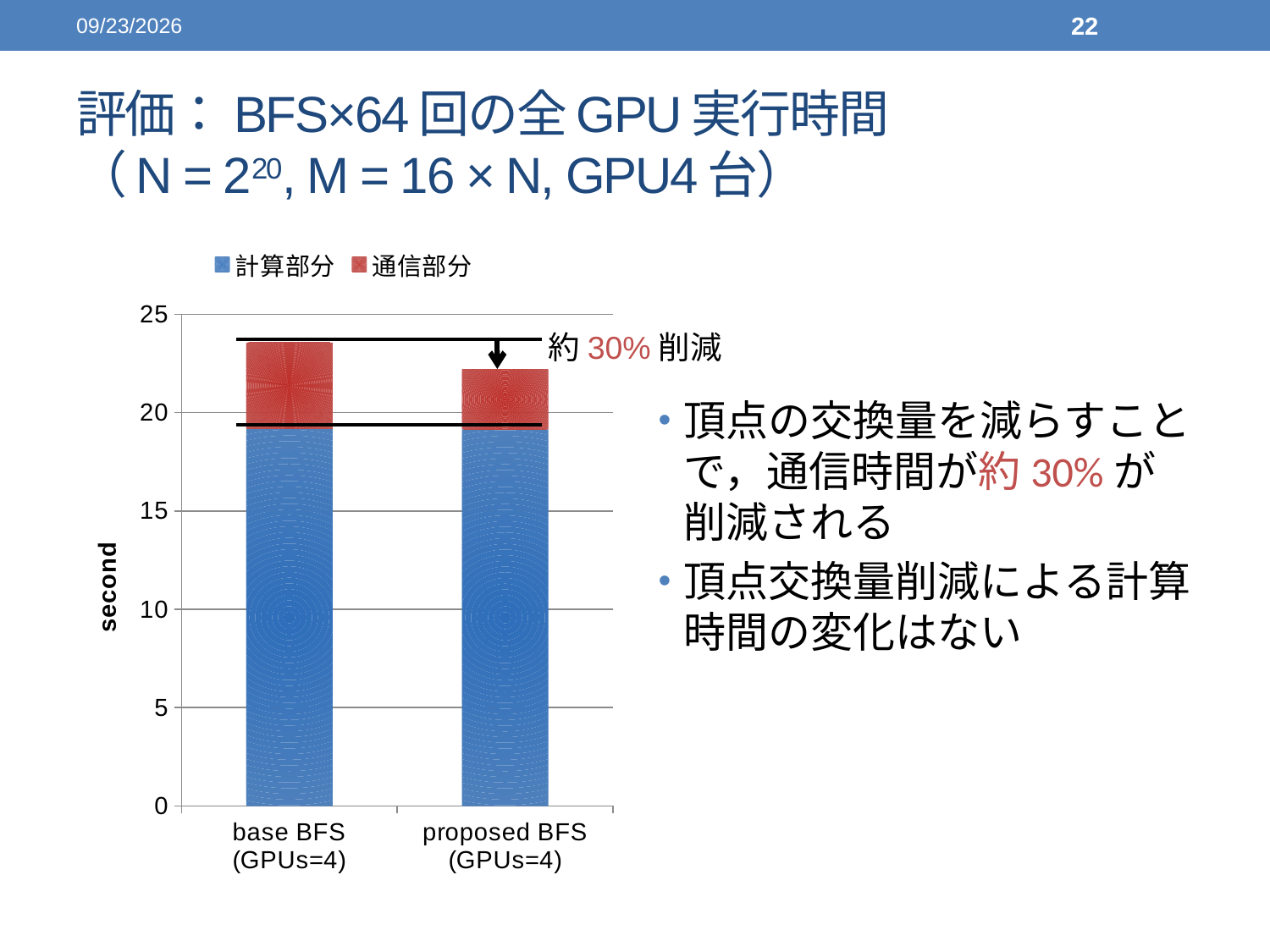
What is the label of the y axis of the chart? second Is the 通信部分 value for proposed BFS (GPUs=4) greater or less than 5? less How many categories are shown on the x axis of the chart? 2 Is the total value for base BFS (GPUs=4) greater or less than 20? greater How many series does the chart legend list? 2 What kind of chart is shown on the slide? stacked bar chart Which category has the larger 通信部分 segment, base BFS (GPUs=4) or proposed BFS (GPUs=4)? base BFS (GPUs=4) Which category has the lowest total bar in the chart? proposed BFS (GPUs=4) Which category has the highest total bar in the chart? base BFS (GPUs=4) Which series are listed in the chart legend? 計算部分, 通信部分 Is the total value for proposed BFS (GPUs=4) greater or less than 25? less Which bar has the greater total height, base BFS (GPUs=4) or proposed BFS (GPUs=4)? base BFS (GPUs=4)